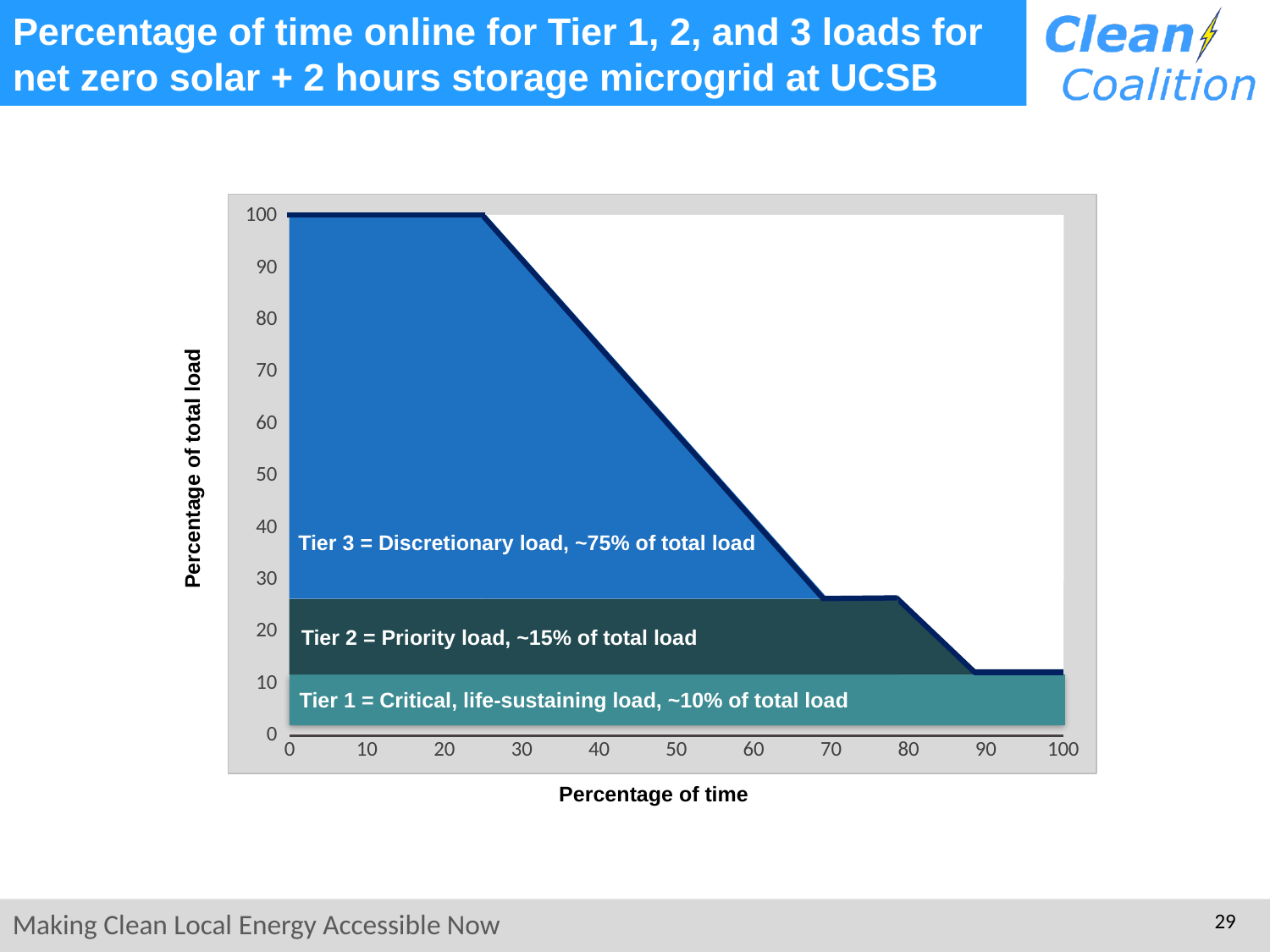
What is the percentage of total load at 20 percent of time? 100 What is the percentage of total load at 0 percent of time? 100 What is the label of the y axis? Percentage of total load What kind of chart is shown on the slide? area chart Does the percentage of total load rise or fall as the percentage of time increases? fall Is the percentage of total load at 30 percent of time greater or less than 80? greater How many load tiers are labelled on the chart? 3 Is the percentage of total load at 60 percent of time greater or less than 50? less Is the percentage of total load at 90 percent of time greater or less than 20? less What is the highest value shown on the y axis? 100 What is the label of the x axis? Percentage of time